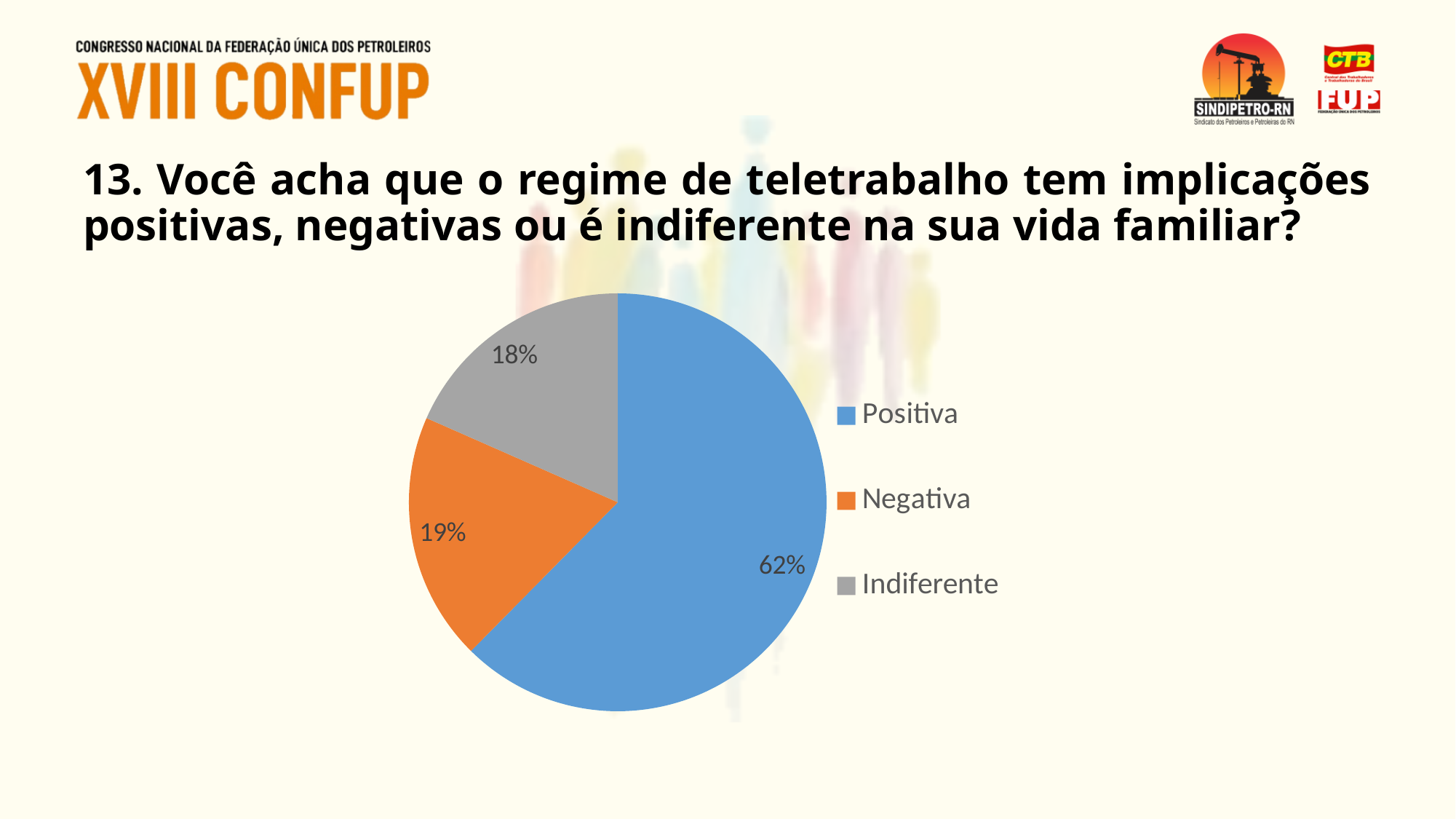
What percentage of respondents answered Indiferente? 18% What is the difference in percentage points between Negativa and Indiferente? 1 How many categories does the pie chart have? 3 Which category has the largest share of the pie? Positiva What percentage of respondents answered Negativa? 19% What colour is the Negativa slice? orange What percentage of respondents answered Positiva? 62% What kind of chart is shown on the slide? pie chart What is the difference in percentage points between Positiva and Negativa? 43 What is the combined share of Negativa and Indiferente? 37% Which category has the smallest share of the pie? Indiferente Which is larger, the share for Positiva or the share for Indiferente? Positiva